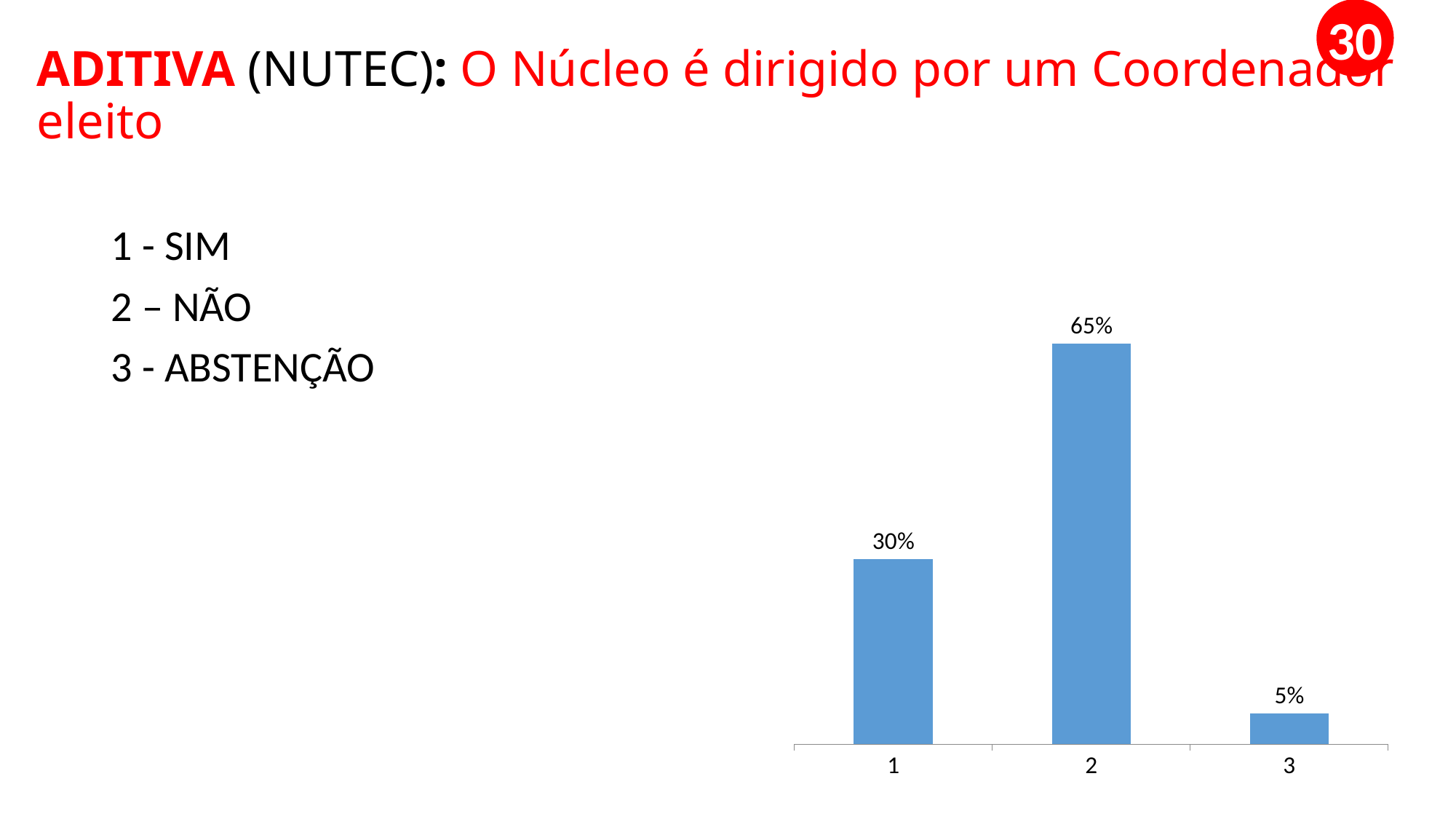
What kind of chart is shown on the slide? bar chart Which category has the lowest value? 3 According to the slide's key, what does category 2 stand for? NÃO Which is larger, the value for category 1 or category 3? category 1 What is the difference between the values for category 2 and category 1? 35% What colour are the bars in the chart? blue What is the value for category 3? 5% Which category has the highest value? 2 What is the difference between the values for category 1 and category 3? 25% What is the value for category 2? 65% How many categories are shown on the x axis? 3 What is the value for category 1? 30%